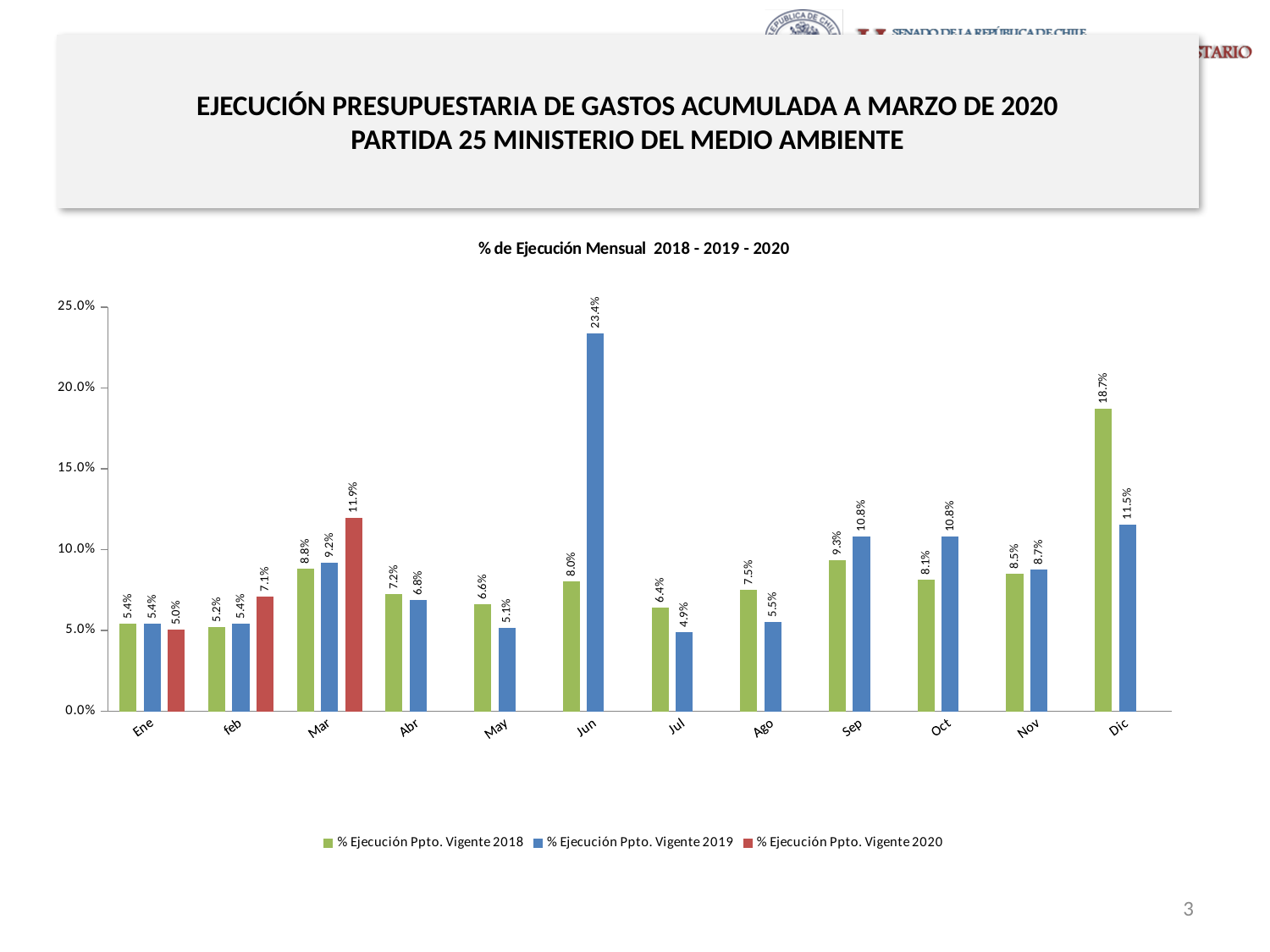
Which is larger in Dic: the 2018 value or the 2019 value? 2018 Which month has the lowest value for % Ejecución Ppto. Vigente 2019? Jul What is the difference between the 2020 and 2018 values in Mar? 3.1% What is the value for % Ejecución Ppto. Vigente 2019 in Jun? 23.4% What is the value for % Ejecución Ppto. Vigente 2020 in Mar? 11.9% Is the value for % Ejecución Ppto. Vigente 2019 in Jun greater or less than 20.0%? greater How many series does the legend list? 3 What is the value for % Ejecución Ppto. Vigente 2018 in Dic? 18.7% Which month has the highest value for % Ejecución Ppto. Vigente 2019? Jun What kind of chart is shown on the slide? Bar chart How many months are shown on the x axis? 12 What is the title of the chart? % de Ejecución Mensual 2018 - 2019 - 2020